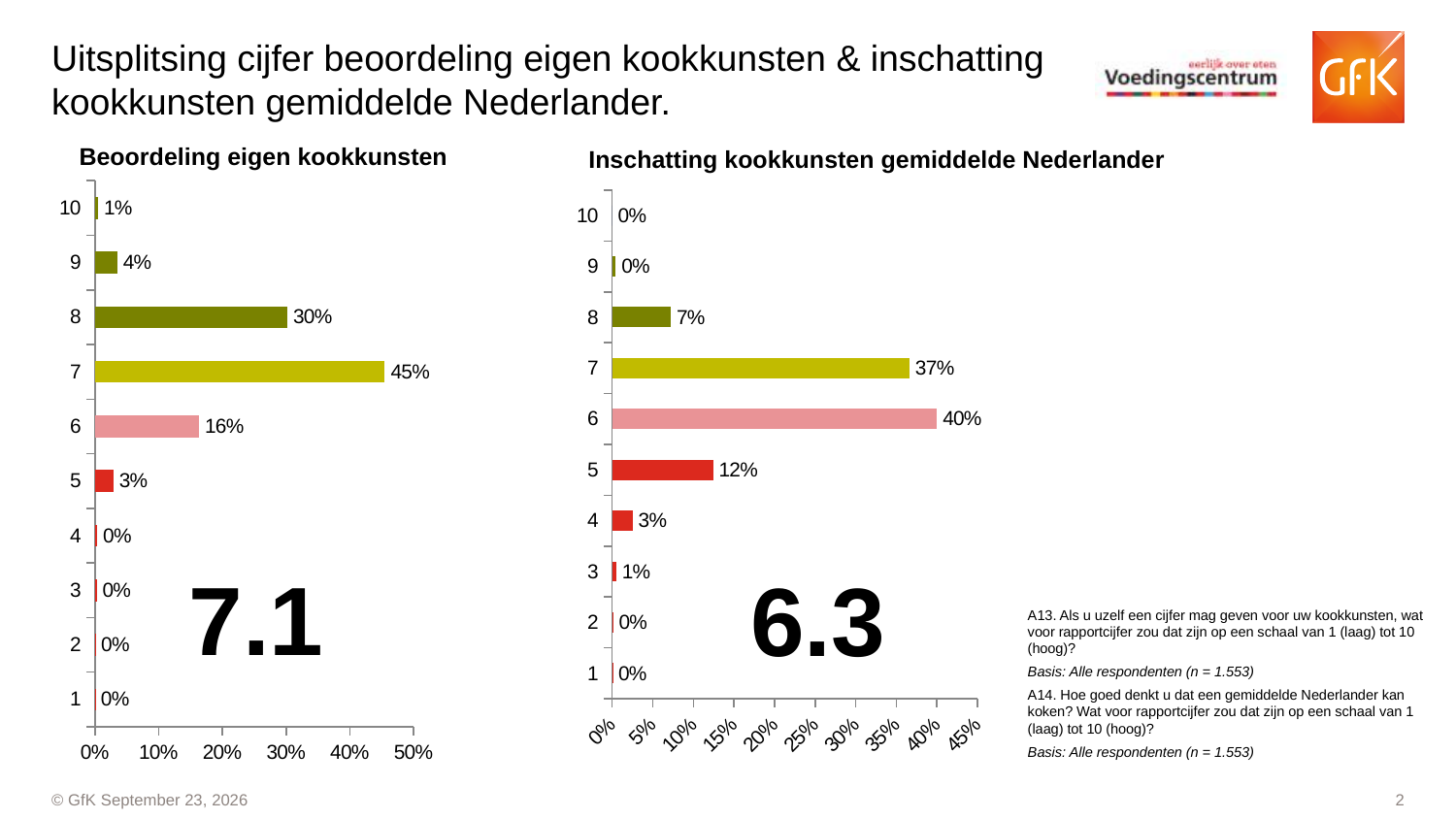
In the 'Inschatting kookkunsten gemiddelde Nederlander' chart, which score has the highest percentage? 6 How many score categories are shown on the y axis of the 'Beoordeling eigen kookkunsten' chart? 10 What type of chart is the 'Inschatting kookkunsten gemiddelde Nederlander' chart? Bar chart What large number is printed inside the 'Beoordeling eigen kookkunsten' chart? 7.1 In the 'Inschatting kookkunsten gemiddelde Nederlander' chart, what is the difference between the values for score 6 and score 7? 3% Which is larger: the value for score 6 in the 'Beoordeling eigen kookkunsten' chart or the value for score 6 in the 'Inschatting kookkunsten gemiddelde Nederlander' chart? Inschatting kookkunsten gemiddelde Nederlander In the 'Beoordeling eigen kookkunsten' chart, what is the difference between the values for score 7 and score 8? 15% In the 'Beoordeling eigen kookkunsten' chart, which score has the highest percentage? 7 In the 'Beoordeling eigen kookkunsten' chart, what percentage of respondents gave themselves a 7? 45% In the 'Inschatting kookkunsten gemiddelde Nederlander' chart, what is the value for score 6? 40% In the 'Beoordeling eigen kookkunsten' chart, what is the value for score 8? 30% In the 'Inschatting kookkunsten gemiddelde Nederlander' chart, what is the value for score 5? 12%